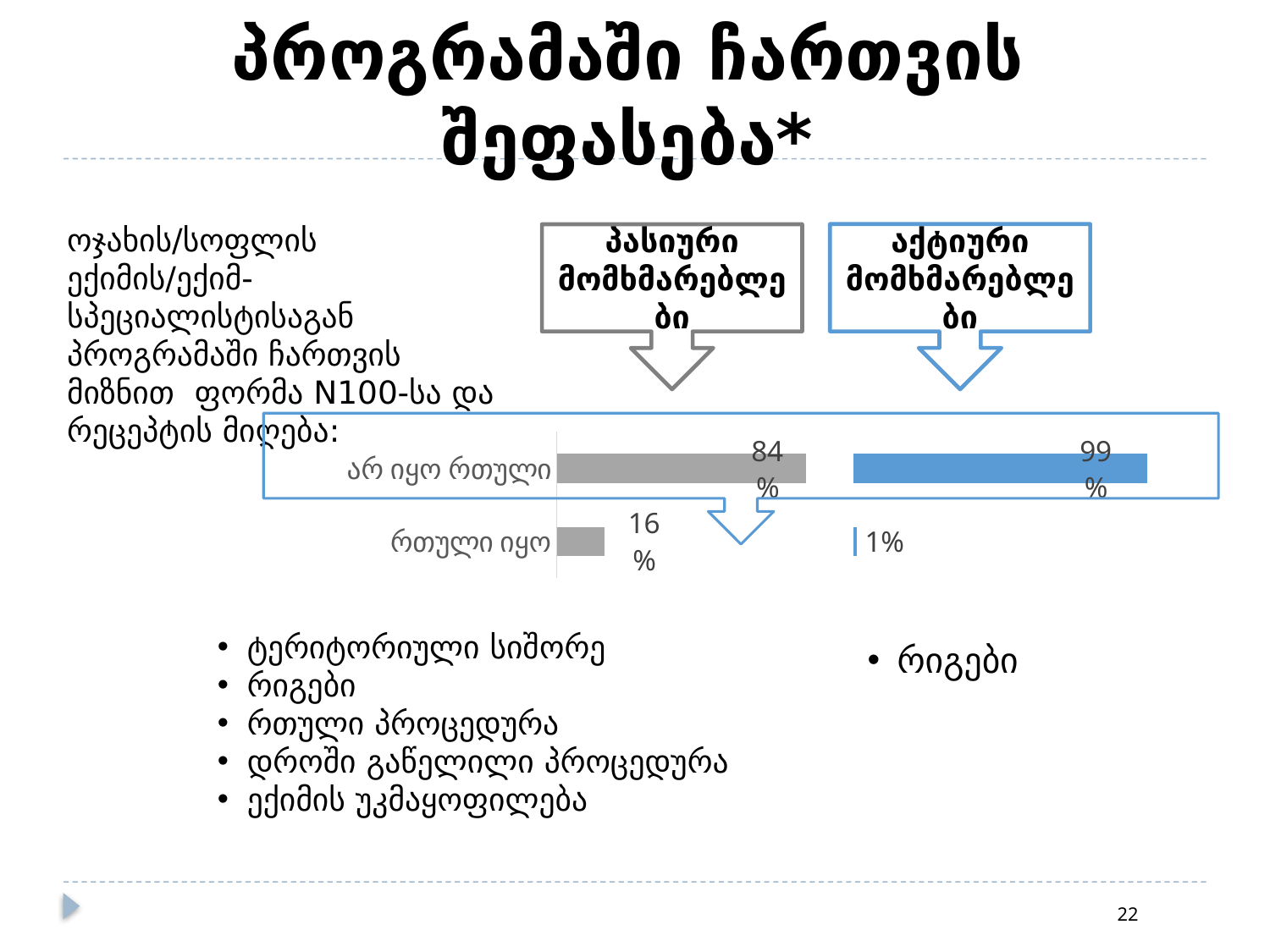
Which group has the larger share for "არ იყო რთული": passive users or active users? Active users For passive users, what is the difference in percentage points between "არ იყო რთული" and "რთული იყო"? 68 percentage points What percentage of active users (აქტიური მომხმარებლები, blue bars) answered "არ იყო რთული"? 99% Which category has the highest value among the gray (passive users) bars? არ იყო რთული Which category has the lowest value among the blue (active users) bars? რთული იყო What type of chart is shown on the slide? Bar chart What percentage of passive users (პასიური მომხმარებლები, gray bars) answered "არ იყო რთული"? 84% What percentage of passive users (gray bars) answered "რთული იყო"? 16% For active users, what is the difference in percentage points between "არ იყო რთული" and "რთული იყო"? 98 percentage points What percentage of active users (blue bars) answered "რთული იყო"? 1% How many categories are shown on the chart's vertical axis? 2 How many percentage points higher is the "არ იყო რთული" share for active users than for passive users? 15 percentage points